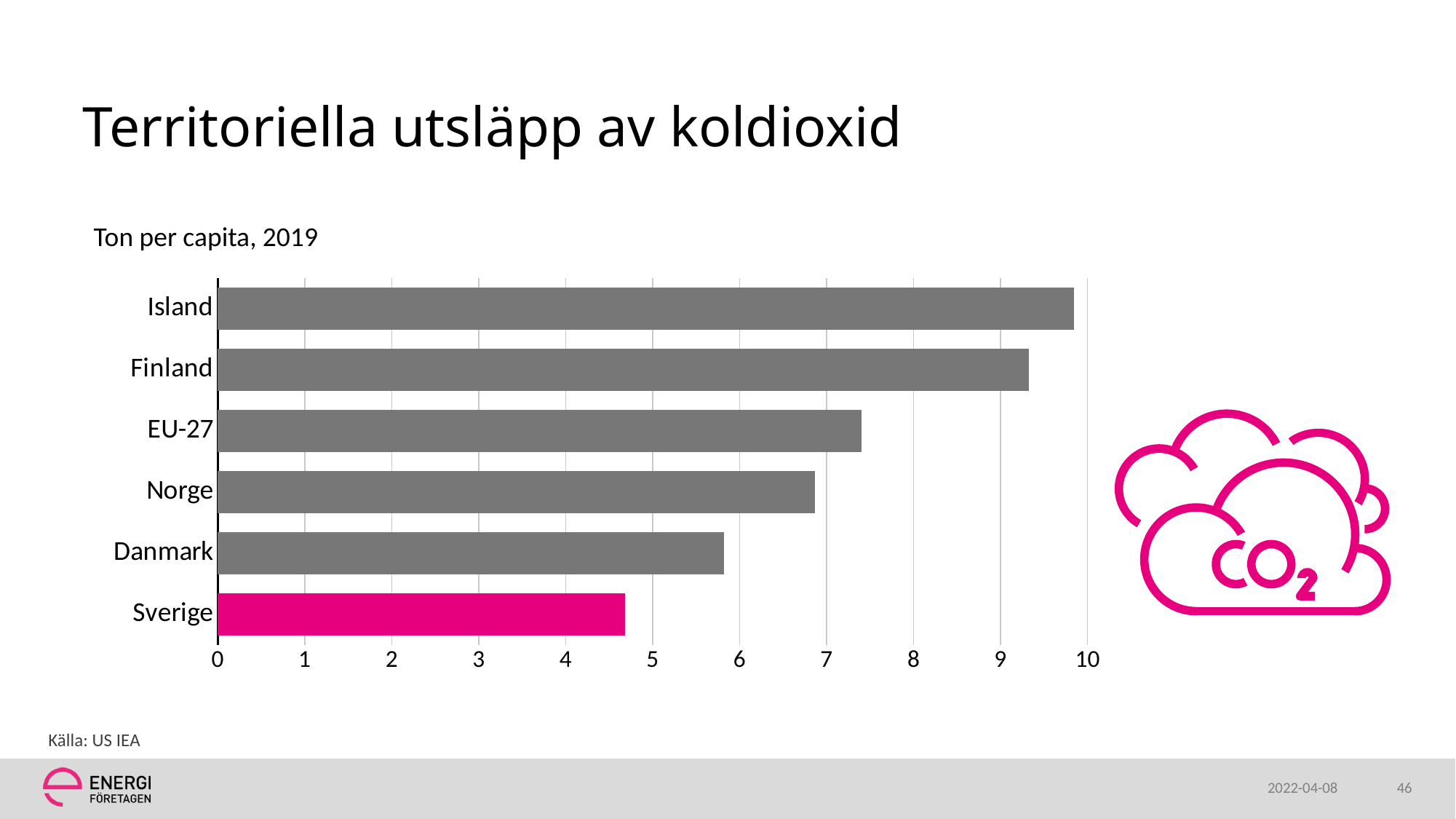
Is the value for Island greater or less than 9? greater Which country has the highest territorial CO2 emissions per capita in the chart? Island Is the value for Norge greater or less than 7? less Is the value for EU-27 greater or less than 7? greater Which country has the lowest territorial CO2 emissions per capita in the chart? Sverige What unit and year does the chart subtitle state? Ton per capita, 2019 Which has the larger value, Danmark or Sverige? Danmark Which has the larger value, EU-27 or Norge? EU-27 What kind of chart is shown on the slide? bar chart How many countries or regions are shown in the chart? 6